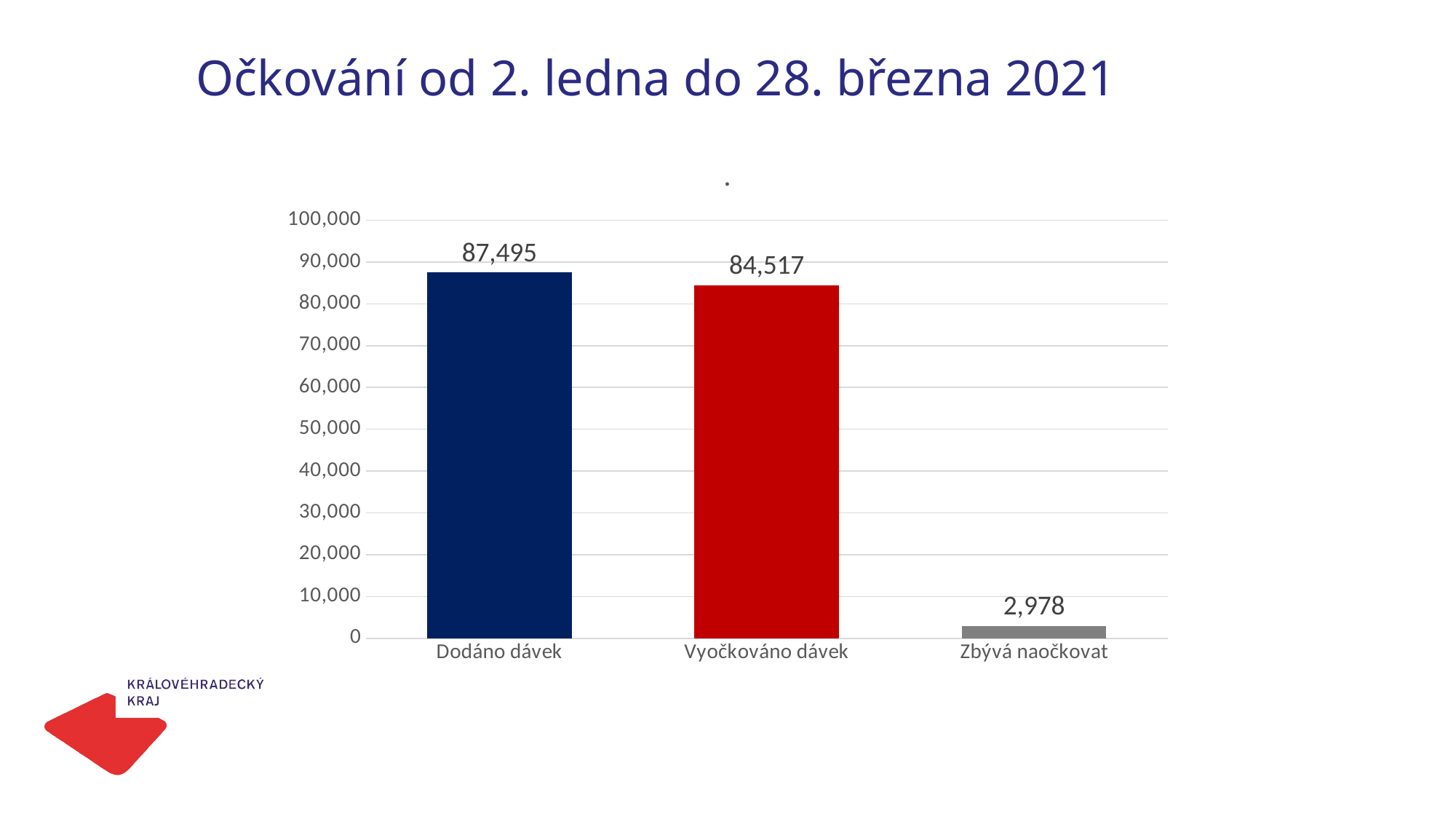
What is the value for Vyočkováno dávek? 84,517 What is the difference between Dodáno dávek and Vyočkováno dávek? 2,978 How many categories are shown in the chart? 3 Is the value for Vyočkováno dávek greater or less than 80,000? greater What is the value for Dodáno dávek? 87,495 What is the difference between Vyočkováno dávek and Zbývá naočkovat? 81,539 Which category has the lowest value? Zbývá naočkovat What kind of chart is shown on the slide? bar chart Which category has the highest value? Dodáno dávek What colour is the bar for Vyočkováno dávek? red Which is larger, Dodáno dávek or Vyočkováno dávek? Dodáno dávek What is the value for Zbývá naočkovat? 2,978